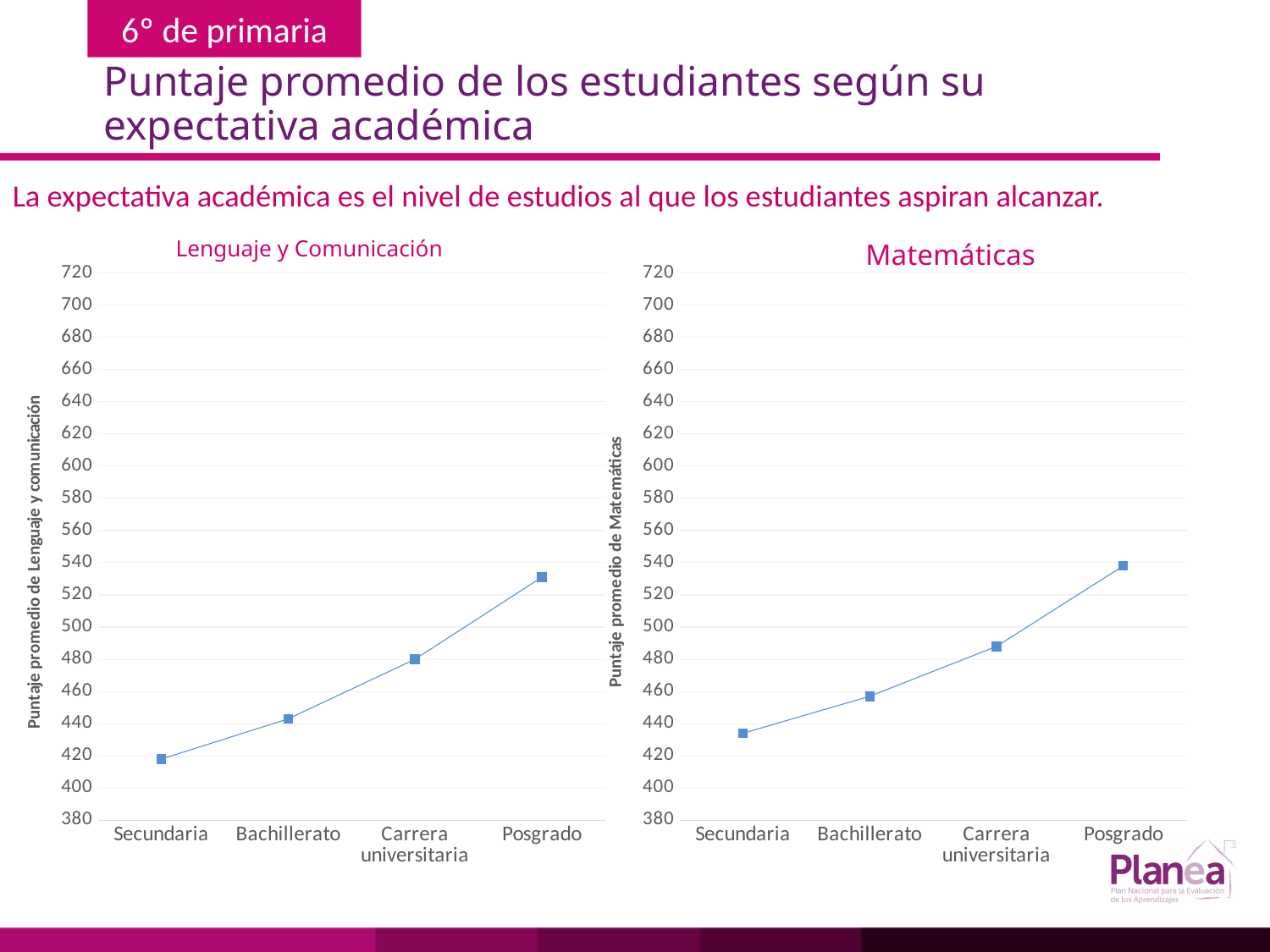
In the 'Matemáticas' chart, is the value for Carrera universitaria greater or less than 480? greater In the 'Matemáticas' chart, is the value for Secundaria greater or less than 440? less What is the title of the chart on the left of the slide? Lenguaje y Comunicación In the 'Lenguaje y Comunicación' chart, is the value for Posgrado greater or less than 520? greater What kind of chart is the 'Lenguaje y Comunicación' chart? line chart What is the y-axis label of the 'Matemáticas' chart? Puntaje promedio de Matemáticas In the 'Matemáticas' chart, which is larger, the value for Bachillerato or the value for Carrera universitaria? Carrera universitaria How many categories are shown on the x axis of the 'Matemáticas' chart? 4 In the 'Lenguaje y Comunicación' chart, which category has the lowest value? Secundaria In the 'Matemáticas' chart, which category has the highest value? Posgrado In the 'Lenguaje y Comunicación' chart, do the values rise or fall from Secundaria to Posgrado? rise